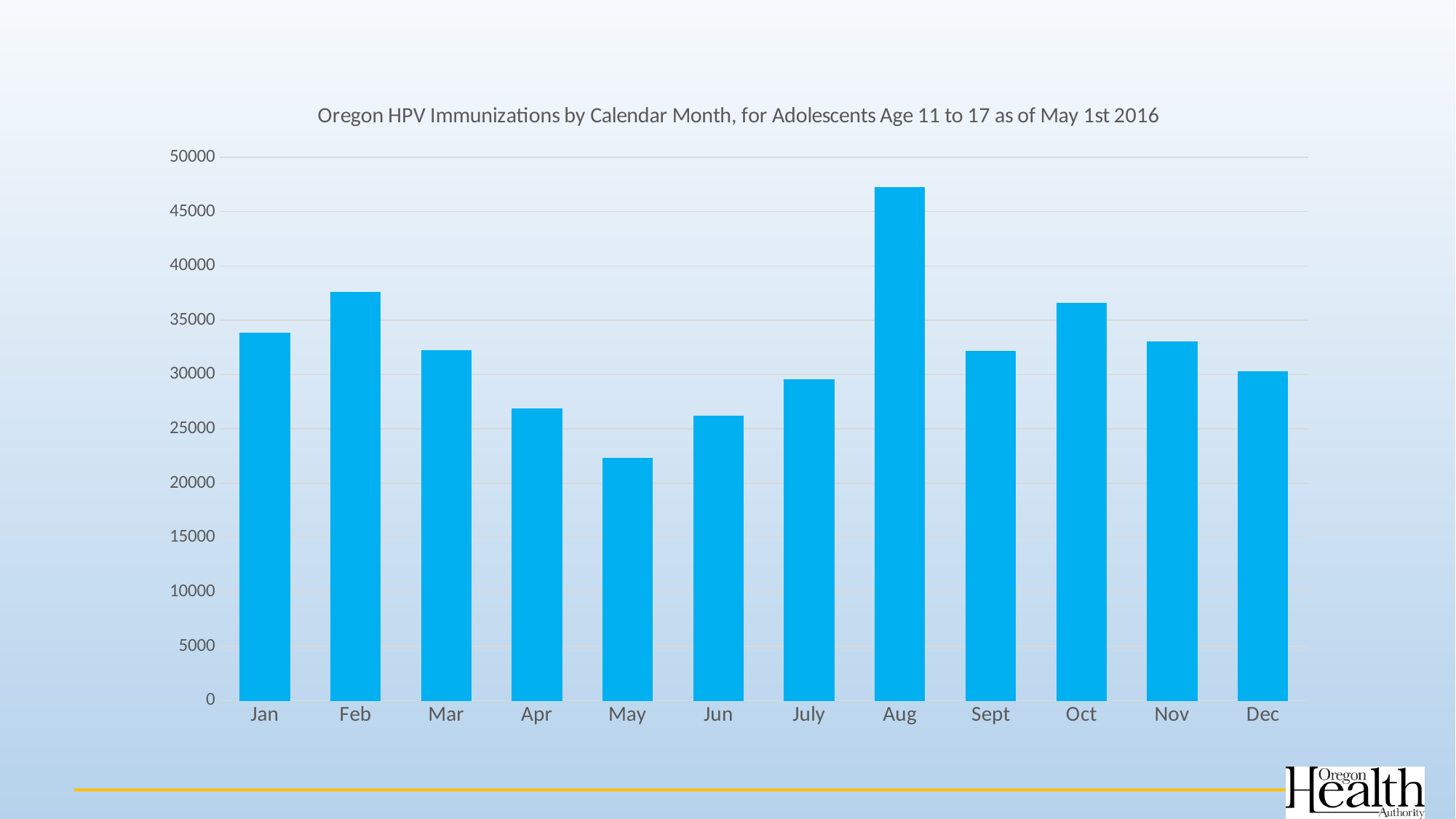
Which is larger, the value for Nov or the value for Dec? Nov Is the value for May greater or less than 25000? less Is the value for July greater or less than 30000? less What is the title of the chart? Oregon HPV Immunizations by Calendar Month, for Adolescents Age 11 to 17 as of May 1st 2016 Is the value for Aug greater or less than 45000? greater Which month has the highest number of HPV immunizations? Aug Which is larger, the value for Jan or the value for Apr? Jan Which month has the lowest number of HPV immunizations? May What kind of chart is shown on the slide? bar chart How many months are plotted on the chart? 12 Do the values rise or fall from Jun to Aug? rise